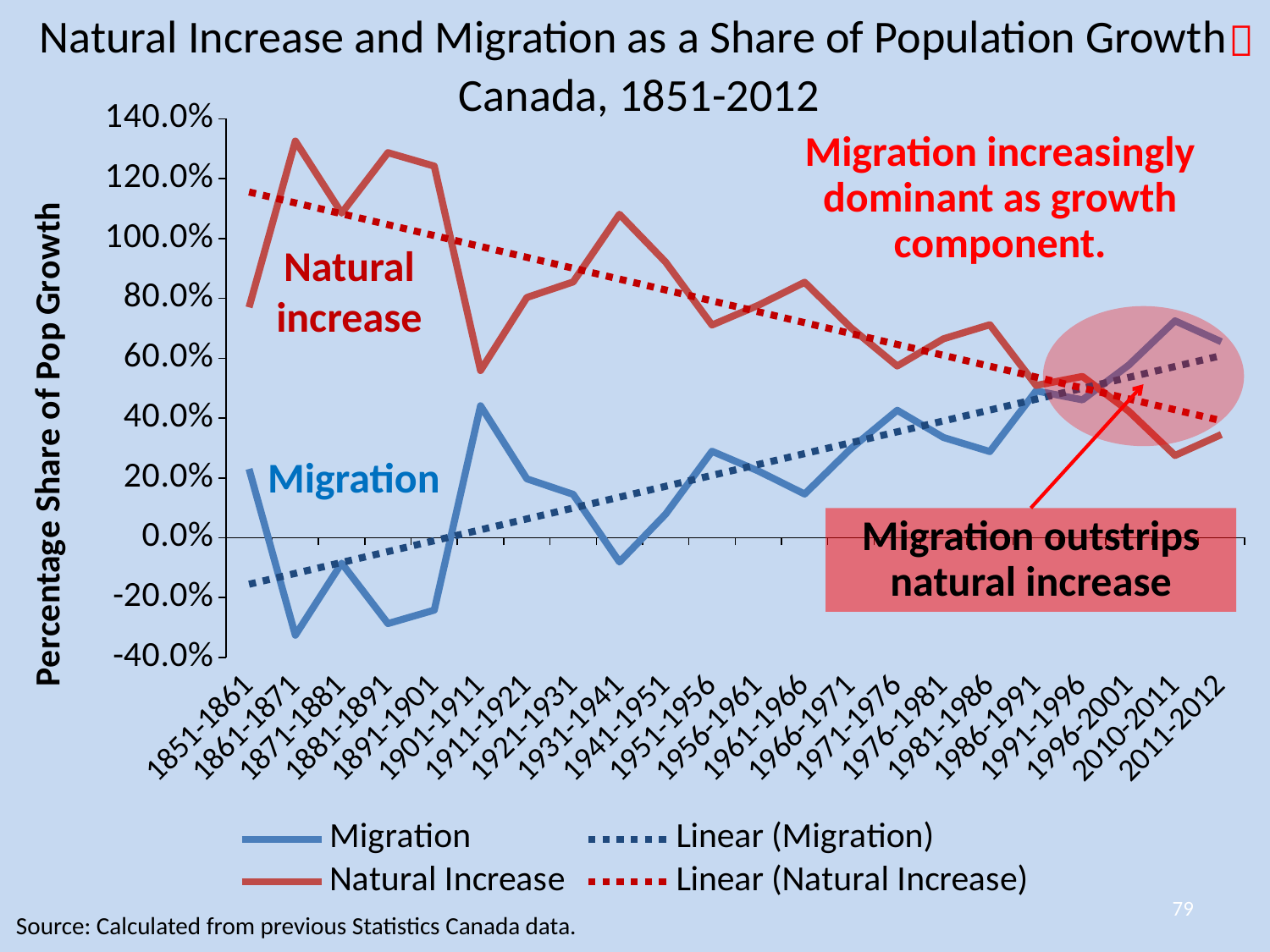
How many time periods are shown along the x axis? 22 What kind of chart is shown on the slide? Line chart Is the Migration value for 2010-2011 greater or less than 60.0%? greater For 1851-1861, which is larger: Natural Increase or Migration? Natural Increase Is the Migration value for 1931-1941 greater or less than 0.0%? less Is the Natural Increase value for 1931-1941 greater or less than 100.0%? greater In which period does the Migration series reach its highest value? 2010-2011 Does the Migration series generally rise or fall across the periods from 1851-1861 to 2011-2012? Rise How many entries does the chart legend list? 4